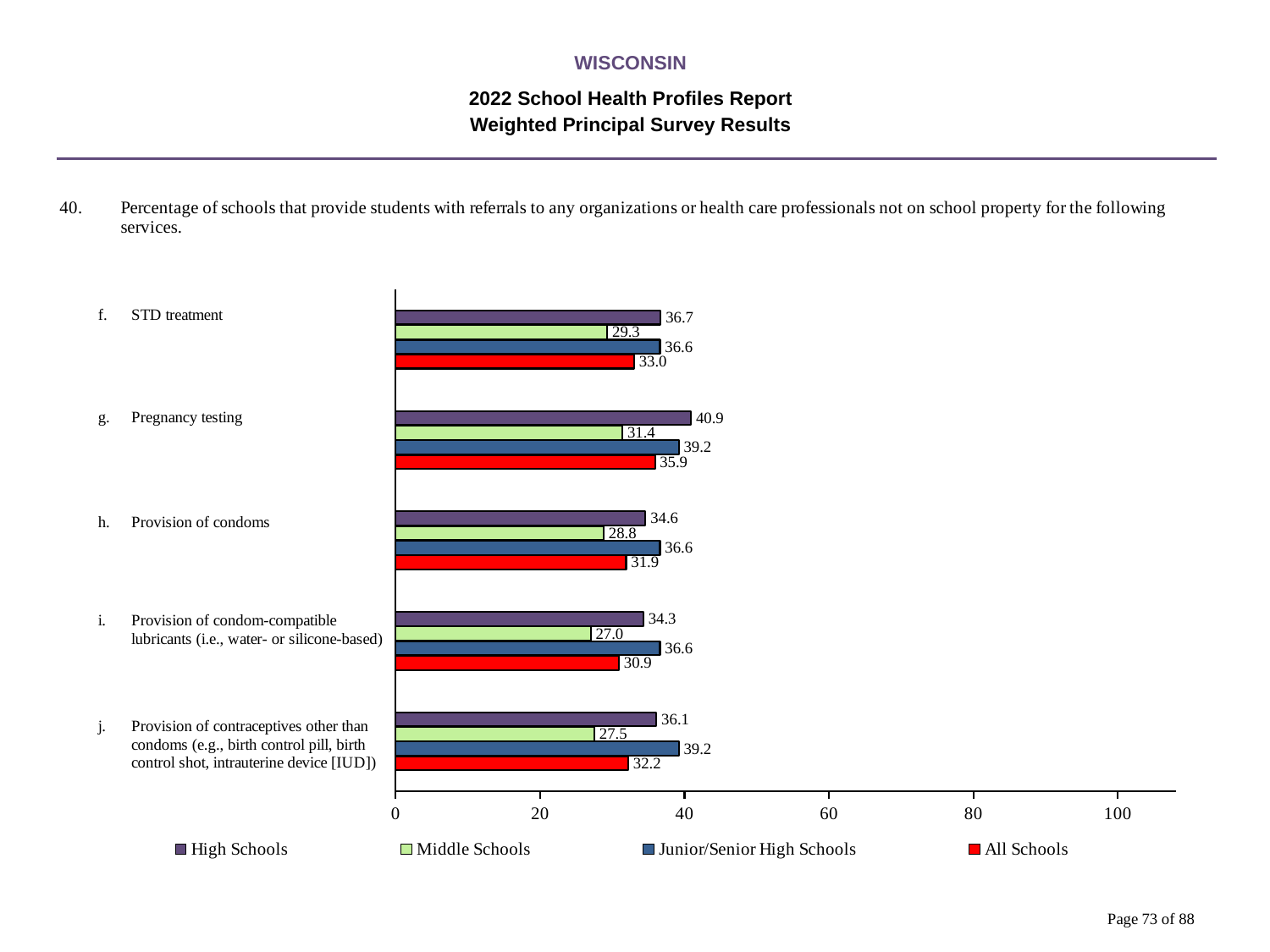
How many series does the legend list? 4 Which category has the lowest value for Middle Schools? Provision of condom-compatible lubricants What is the difference between the High Schools and Middle Schools values for STD treatment? 7.4 What is the value for Junior/Senior High Schools for Provision of contraceptives other than condoms? 39.2 What is the value for All Schools for STD treatment? 33.0 What is the value for High Schools for Pregnancy testing? 40.9 How many categories are shown in the chart? 5 For Provision of condoms, which is larger: the High Schools value or the Junior/Senior High Schools value? Junior/Senior High Schools Which category has the highest value for High Schools? Pregnancy testing What colour represents All Schools in the legend? Red What kind of chart is shown on the slide? Bar chart What is the value for Middle Schools for Provision of condom-compatible lubricants? 27.0